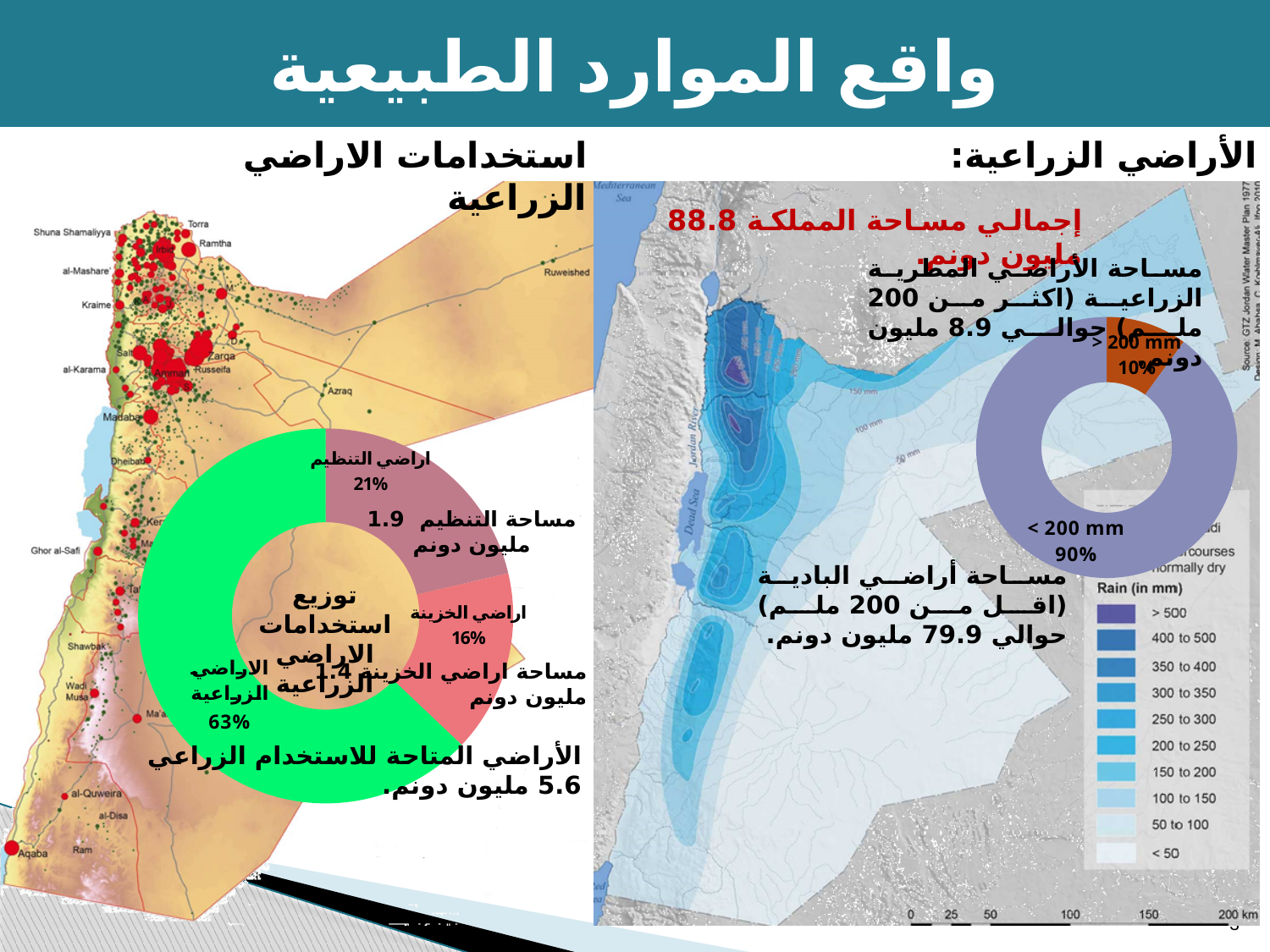
On the left doughnut chart, which category has the smallest share? اراضي الخزينة On the left doughnut chart, what percentage is shown for الاراضي الزراعية? 63% On the right doughnut chart, which category is larger, > 200 mm or < 200 mm? < 200 mm On the right doughnut chart, what percentage is shown for < 200 mm? 90% On the left doughnut chart, what percentage is shown for اراضي الخزينة? 16% On the right doughnut chart, what percentage is shown for > 200 mm? 10% What type of chart is the chart on the left side of the slide? Doughnut chart On the left doughnut chart, which category has the largest share? الاراضي الزراعية On the left doughnut chart, how many categories are shown? 3 On the right doughnut chart, how many categories are shown? 2 On the left doughnut chart, what is the difference in percentage points between الاراضي الزراعية and اراضي التنظيم? 42 On the left doughnut chart (توزيع استخدامات الاراضي الزراعية), what percentage is shown for اراضي التنظيم? 21%